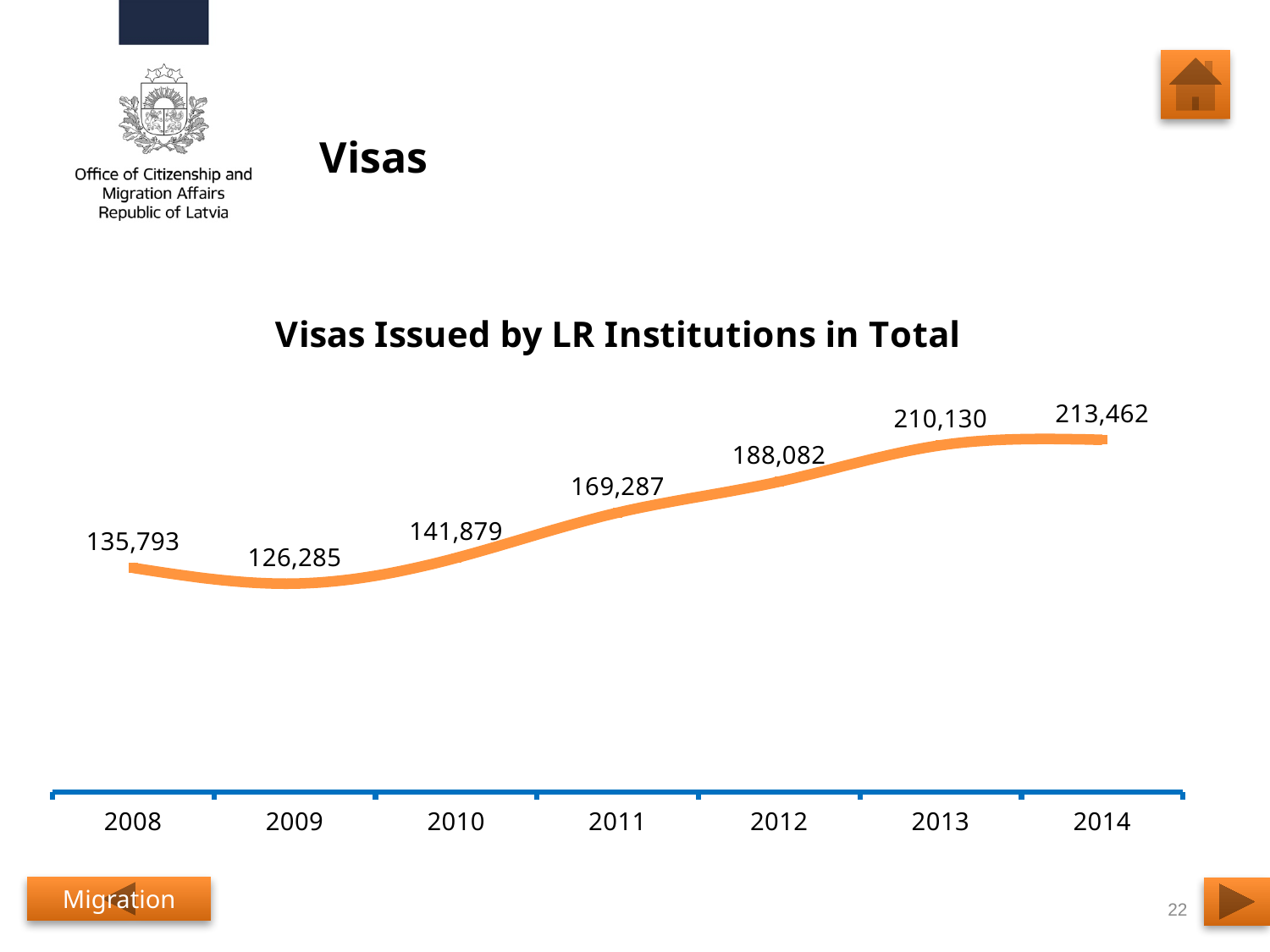
What is the difference between the values for 2014 and 2013? 3,332 By how much did the value fall from 2008 to 2009? 9,508 What is the value shown for 2014? 213,462 Which year has the larger value, 2010 or 2012? 2012 Do the values generally rise or fall from 2009 to 2014? Rise What type of chart is shown on the slide? Line chart How many years are plotted on the chart? 7 What is the value shown for 2009? 126,285 How many visas were issued in 2011 according to the chart? 169,287 Which year has the highest number of visas issued? 2014 Which year has the lowest number of visas issued? 2009 What is the title of the chart? Visas Issued by LR Institutions in Total